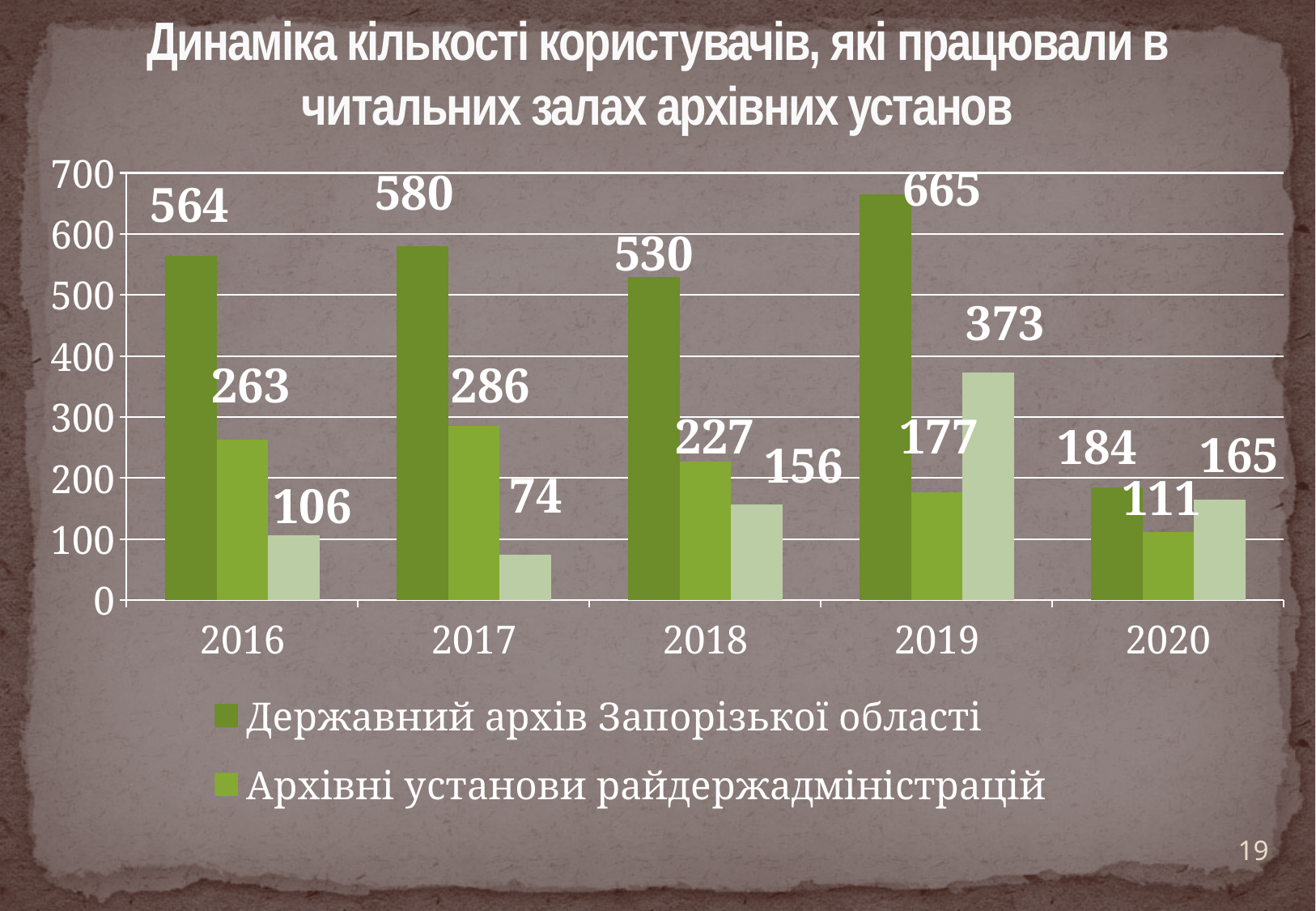
Which is larger in 2018: Державний архів Запорізької області or Архівні установи райдержадміністрацій? Державний архів Запорізької області In which year is the value for Державний архів Запорізької області lowest? 2020 What is the value for Державний архів Запорізької області in 2020? 184 In which year is the value for Державний архів Запорізької області highest? 2019 In which year is the value for Архівні установи райдержадміністрацій lowest? 2020 What is the value for Державний архів Запорізької області in 2019? 665 How many series does the legend list? 2 What is the difference between Державний архів Запорізької області and Архівні установи райдержадміністрацій in 2016? 301 Do the values for Архівні установи райдержадміністрацій rise or fall from 2017 to 2020? fall What is the value for Архівні установи райдержадміністрацій in 2017? 286 How many years are shown on the x axis? 5 What kind of chart is shown on the slide? bar chart